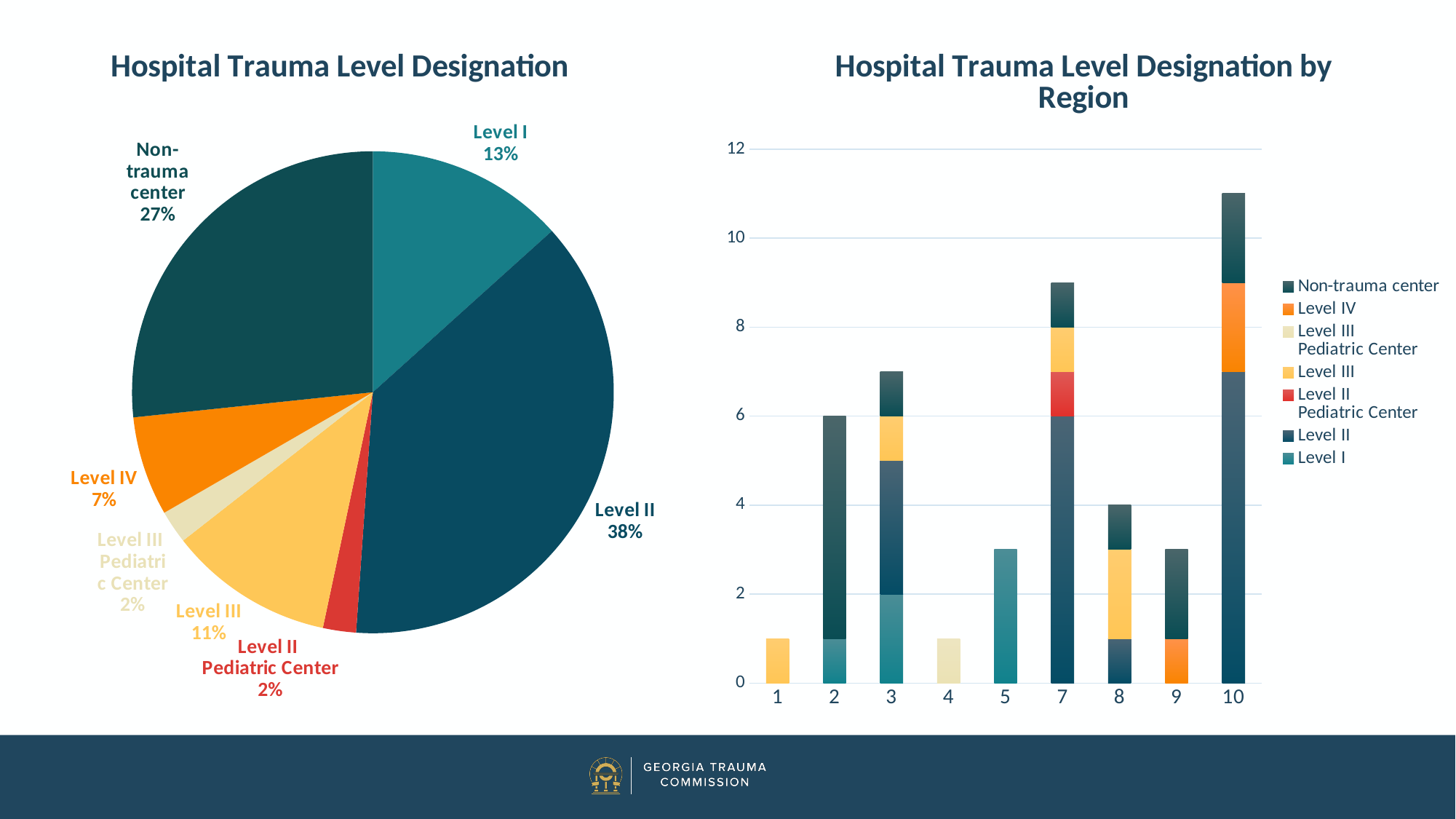
On the pie chart titled 'Hospital Trauma Level Designation', what share is Level II? 38% On the chart titled 'Hospital Trauma Level Designation by Region', how many regions are shown on the x axis? 9 On the chart titled 'Hospital Trauma Level Designation by Region', what is the total height of the bar for region 2? 6 On the pie chart titled 'Hospital Trauma Level Designation', what share is Non-trauma center? 27% On the chart titled 'Hospital Trauma Level Designation by Region', is the total for region 10 greater or less than 10? greater On the chart titled 'Hospital Trauma Level Designation by Region', what kind of chart is shown? Stacked bar chart On the pie chart titled 'Hospital Trauma Level Designation', what is the difference in percentage points between Level II and Non-trauma center? 11 percentage points On the chart titled 'Hospital Trauma Level Designation by Region', which region has the tallest bar? 10 On the pie chart titled 'Hospital Trauma Level Designation', which is larger, Level I or Level IV? Level I On the chart titled 'Hospital Trauma Level Designation by Region', how many series does the legend list? 7 On the pie chart titled 'Hospital Trauma Level Designation', which category has the largest share? Level II On the pie chart titled 'Hospital Trauma Level Designation', what share is Level III? 11%